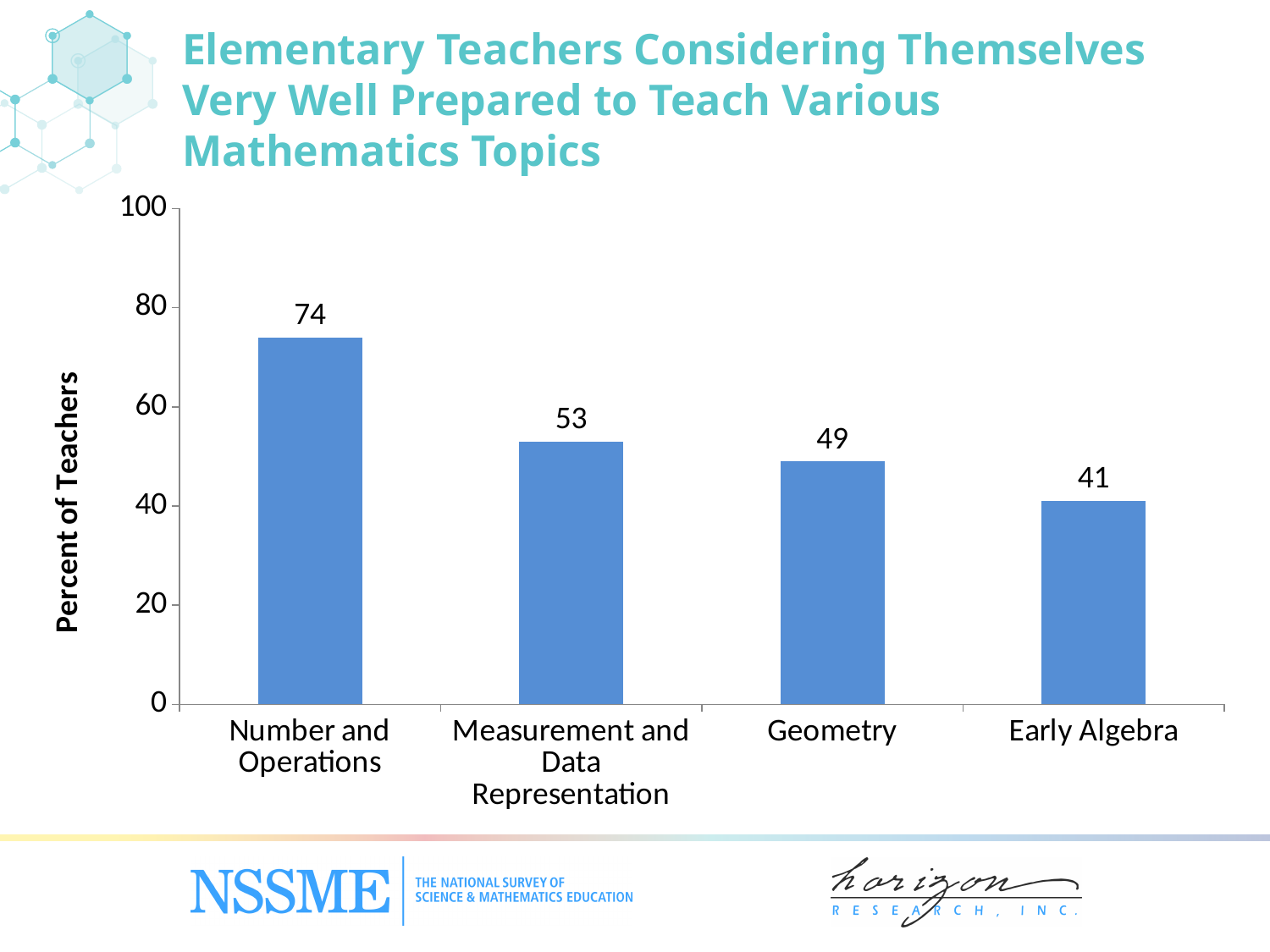
How many topics are shown on the chart? 4 What is the value for Measurement and Data Representation? 53 What kind of chart is shown on the slide? bar chart Which is larger, the value for Geometry or the value for Early Algebra? Geometry Is the value for Number and Operations greater or less than 60? greater What is the value for Early Algebra? 41 Which topic has the highest percent of teachers? Number and Operations What is the value for Geometry? 49 What percent of teachers consider themselves very well prepared to teach Number and Operations? 74 Which topic has the lowest percent of teachers? Early Algebra What is the difference between the values for Measurement and Data Representation and Geometry? 4 What is the difference between the values for Number and Operations and Early Algebra? 33